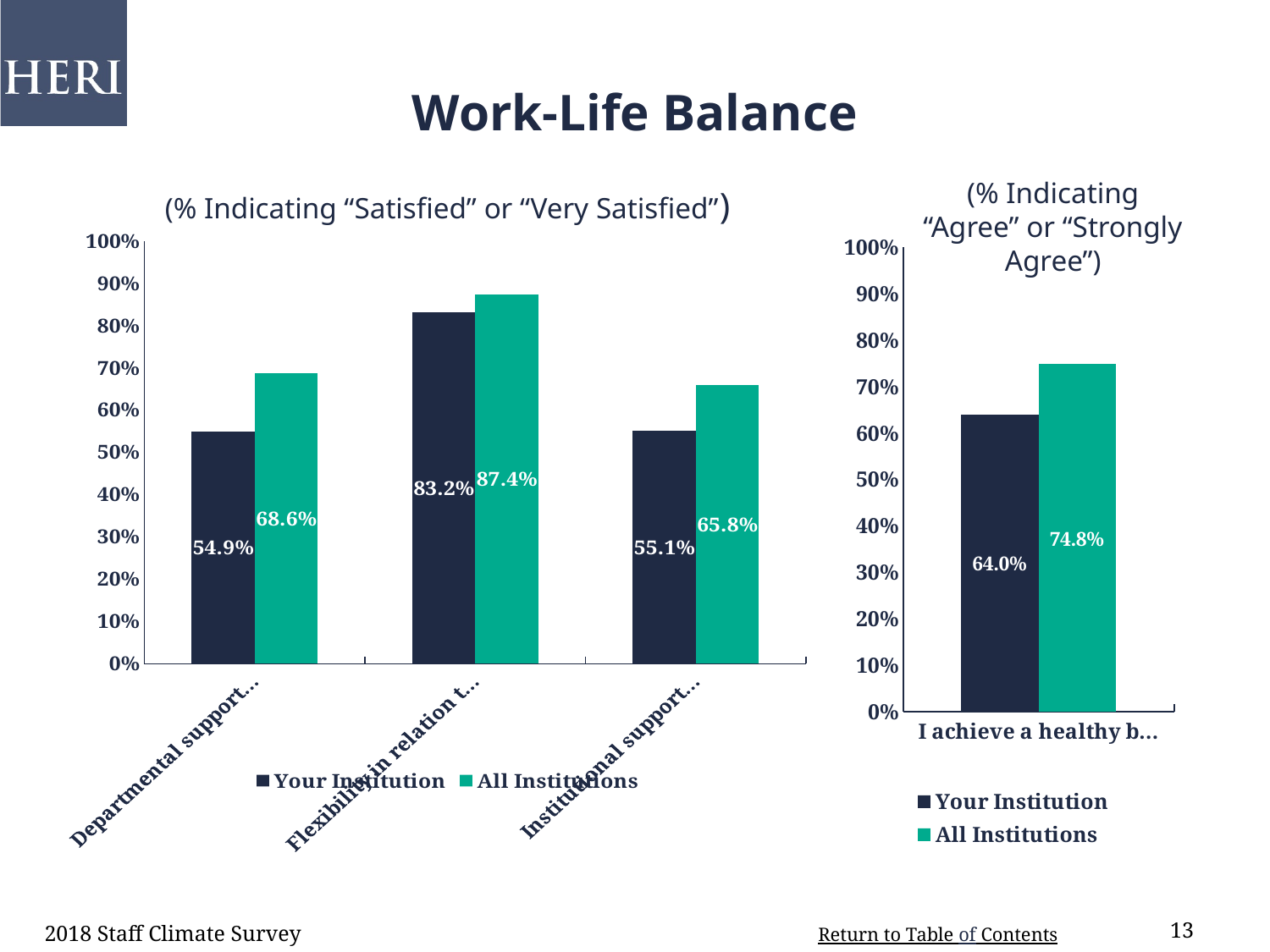
In the left chart (% Indicating "Satisfied" or "Very Satisfied"), what is the value for All Institutions in the Flexibility category? 87.4% How many categories are shown on the x axis of the left chart (% Indicating "Satisfied" or "Very Satisfied")? 3 In the left chart (% Indicating "Satisfied" or "Very Satisfied"), what is the difference between All Institutions and Your Institution in the Departmental support category? 13.7% In the right chart (% Indicating "Agree" or "Strongly Agree"), what is the value for Your Institution? 64.0% What type of chart is the left chart (% Indicating "Satisfied" or "Very Satisfied")? Bar chart In the right chart (% Indicating "Agree" or "Strongly Agree"), what is the difference between All Institutions and Your Institution? 10.8% In the left chart (% Indicating "Satisfied" or "Very Satisfied"), what is the value for Your Institution in the Departmental support category? 54.9% In the left chart (% Indicating "Satisfied" or "Very Satisfied"), which category has the highest value for Your Institution? Flexibility in relation t... In the left chart (% Indicating "Satisfied" or "Very Satisfied"), which category has the lowest value for All Institutions? Institutional support... How many series does the legend of the right chart (% Indicating "Agree" or "Strongly Agree") list? 2 In the left chart (% Indicating "Satisfied" or "Very Satisfied"), which is larger in the Institutional support category: Your Institution or All Institutions? All Institutions In the left chart (% Indicating "Satisfied" or "Very Satisfied"), what is the value for All Institutions in the Institutional support category? 65.8%